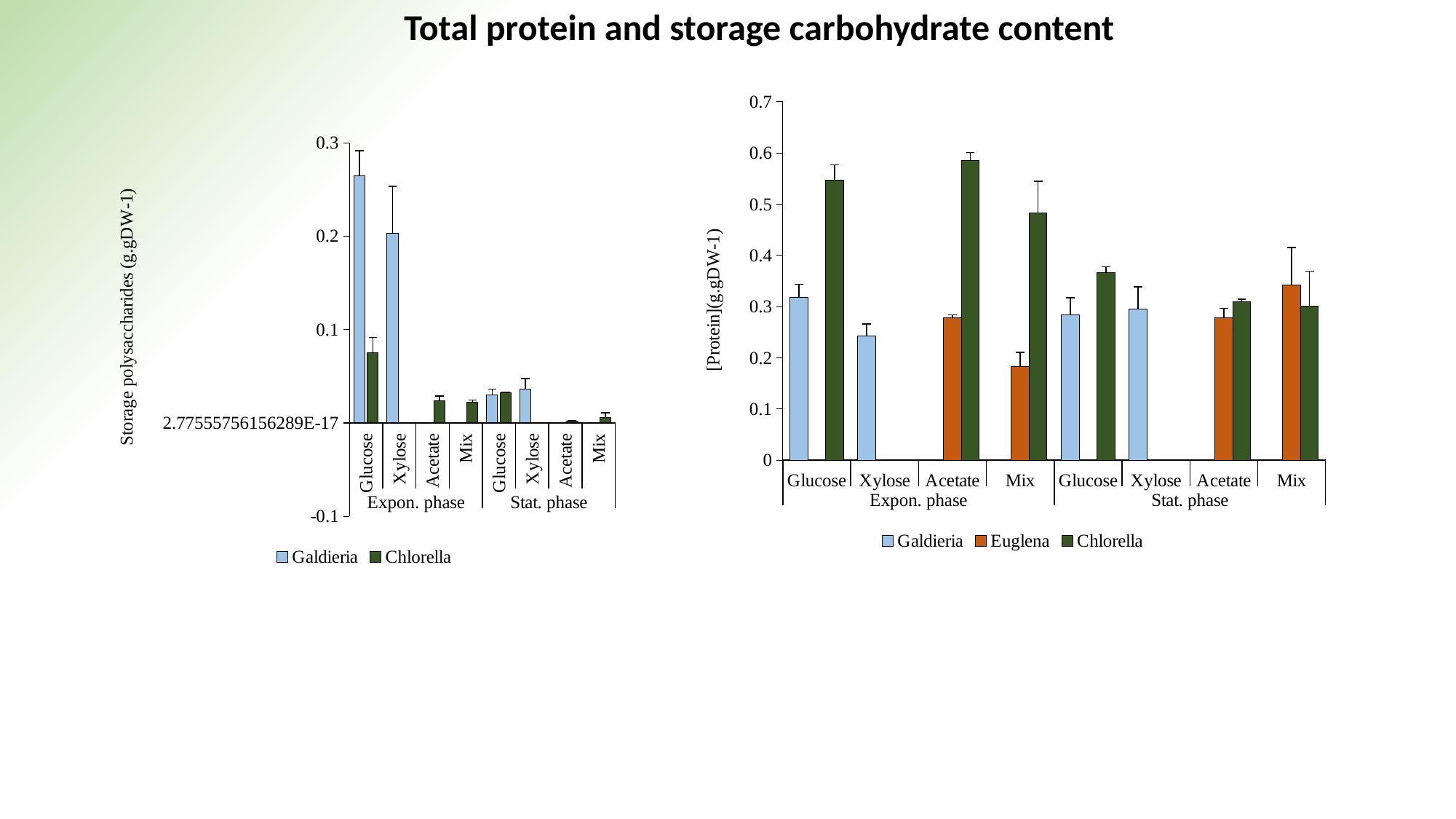
In the right-hand [Protein] chart, is the Euglena value for Mix in the Expon. phase greater or less than 0.3? less In the left-hand Storage polysaccharides chart, for Glucose in the Expon. phase, which is larger: Galdieria or Chlorella? Galdieria In the left-hand Storage polysaccharides chart, which bar is the highest? Galdieria, Glucose, Expon. phase In the right-hand [Protein] chart, is the Chlorella value for Mix in the Expon. phase greater or less than 0.4? greater How many series does the legend of the right-hand [Protein] chart list? 3 In the right-hand [Protein] chart, for Glucose in the Expon. phase, which is larger: Galdieria or Chlorella? Chlorella In the right-hand [Protein] chart, which bar is the highest? Chlorella, Acetate, Expon. phase How many substrate categories are shown along the x axis of the right-hand [Protein] chart, counting both phases? 8 How many series does the legend of the left-hand Storage polysaccharides chart list? 2 What kind of chart is the right-hand chart titled with the y-axis label [Protein](g.gDW-1)? bar chart In the left-hand Storage polysaccharides chart, is the Galdieria value for Glucose in the Expon. phase greater or less than 0.2? greater